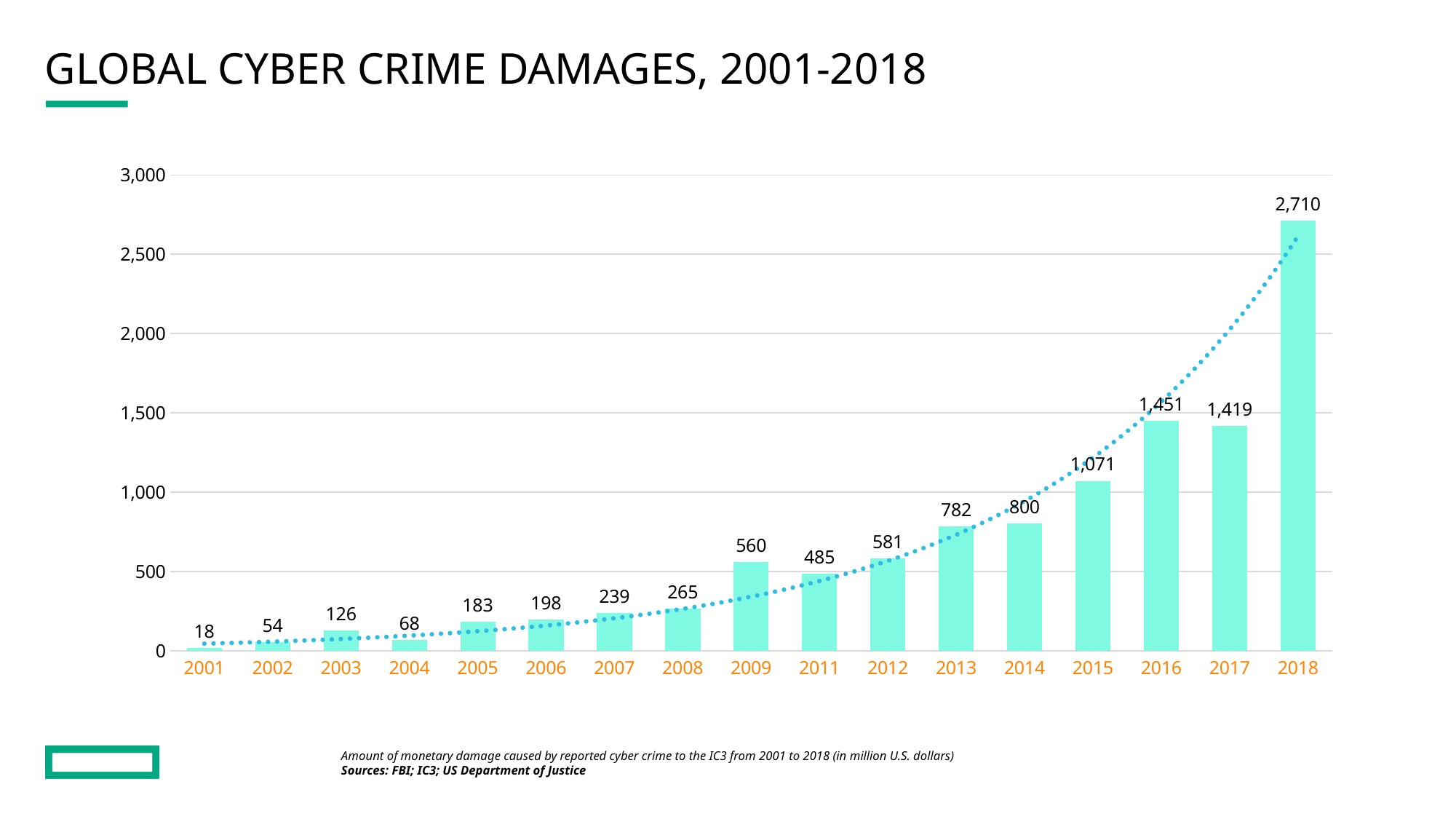
What is the difference between the values for 2018 and 2017? 1,291 What is the difference between the values for 2016 and 2015? 380 Which is larger, the value for 2013 or the value for 2014? 2014 What is the value for 2009? 560 Which year has the highest value? 2018 How many years are shown on the x axis? 17 What is the value for 2018? 2,710 Which year has the lowest value? 2001 What is the value for 2004? 68 What kind of chart is this? bar chart Is the value for 2015 greater or less than 1,000? greater What is the title of the chart? GLOBAL CYBER CRIME DAMAGES, 2001-2018